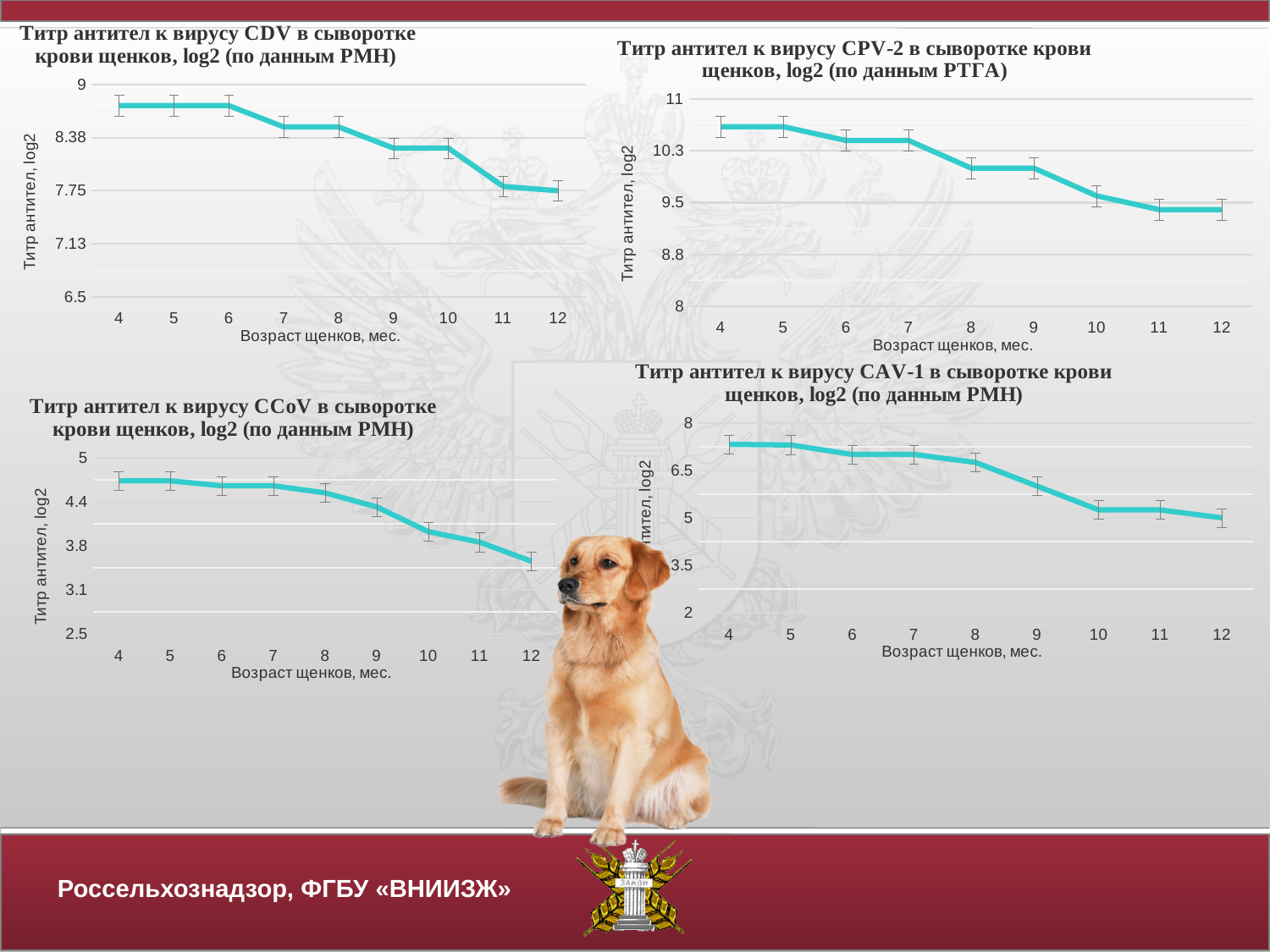
In the 'Титр антител к вирусу CDV' chart, do the values rise or fall as the age of the puppies increases from 4 to 12 months? fall In the 'Титр антител к вирусу CAV-1' chart, is the value at 4 months greater or less than 6.5? greater What is the x-axis label of the 'Титр антител к вирусу CAV-1' chart? Возраст щенков, мес. In the 'Титр антител к вирусу CAV-1' chart, which age in months has the lowest antibody titre? 12 In the 'Титр антител к вирусу CPV-2' chart, is the value at 4 months greater or less than 10.3? greater In the 'Титр антител к вирусу CDV' chart, is the value at 4 months greater or less than 8.38? greater In the 'Титр антител к вирусу CCoV' chart, which is larger, the value at 4 months or the value at 12 months? 4 months What kind of chart is the 'Титр антител к вирусу CDV' chart in the top left? line chart How many data points are plotted in the 'Титр антител к вирусу CPV-2' chart? 9